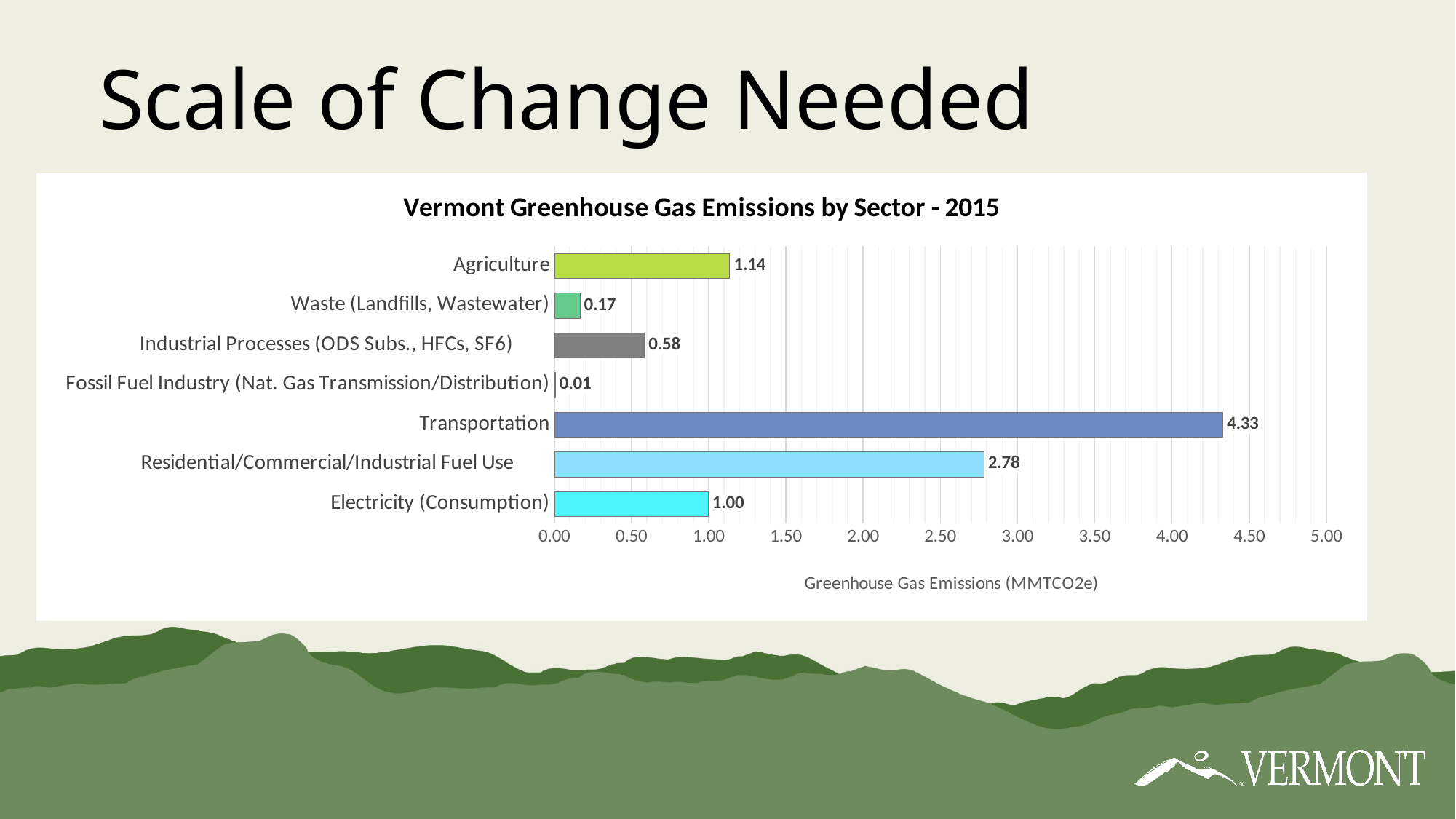
Which sector has the highest greenhouse gas emissions? Transportation What is the value for Agriculture? 1.14 What is the label of the horizontal axis? Greenhouse Gas Emissions (MMTCO2e) How many sectors are shown in the chart? 7 What is the value for Residential/Commercial/Industrial Fuel Use? 2.78 What is the title of the chart? Vermont Greenhouse Gas Emissions by Sector - 2015 What kind of chart is this? Bar chart What is the difference between the values for Transportation and Residential/Commercial/Industrial Fuel Use? 1.55 Which sector has the lowest greenhouse gas emissions? Fossil Fuel Industry (Nat. Gas Transmission/Distribution) What is the value for Transportation? 4.33 What is the value for Waste (Landfills, Wastewater)? 0.17 Which is larger, the value for Agriculture or the value for Electricity (Consumption)? Agriculture